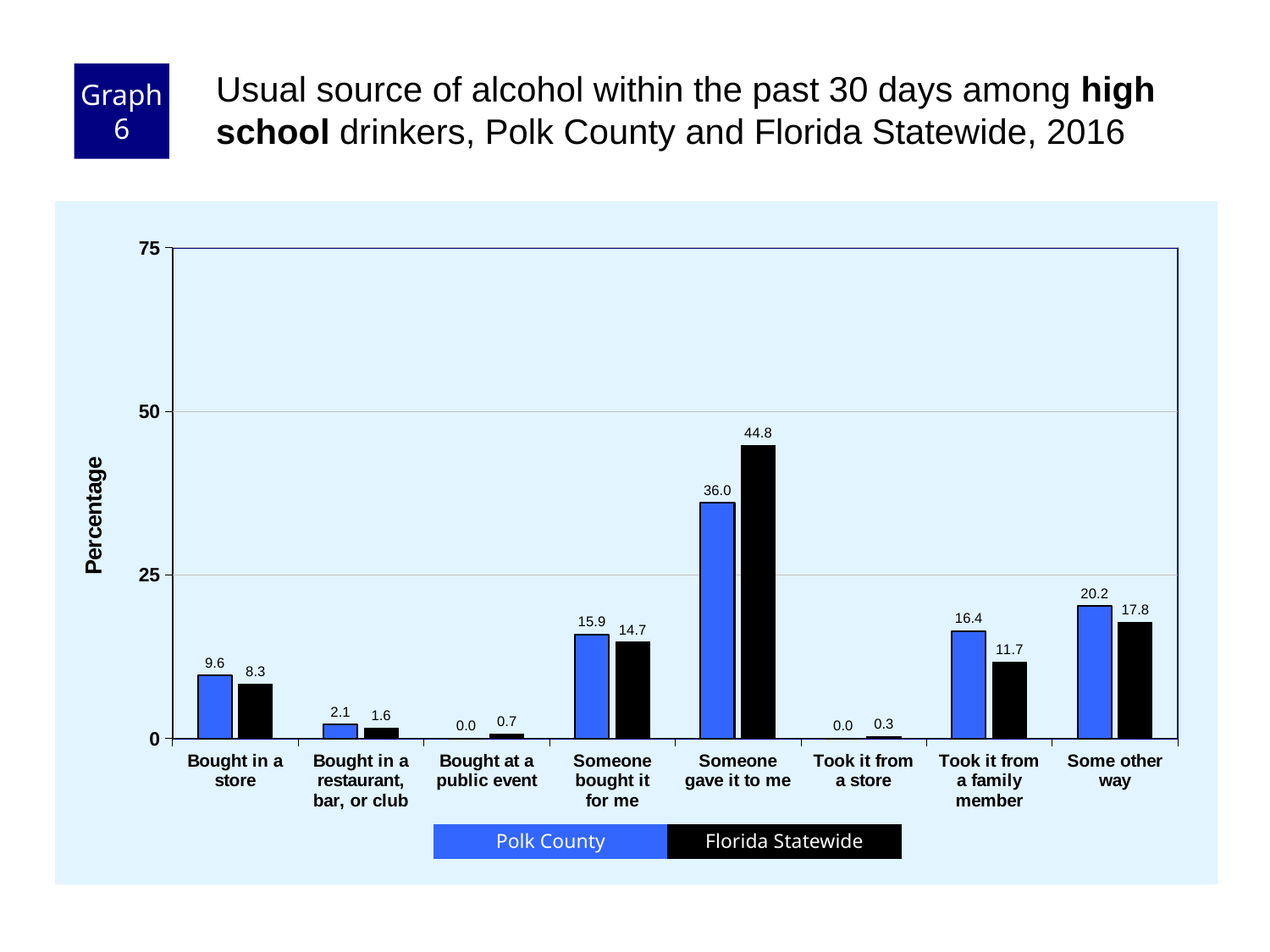
What is the difference between the Florida Statewide and Polk County values for "Someone gave it to me"? 8.8 What is the Florida Statewide value for "Took it from a family member"? 11.7 Which category has the highest Florida Statewide value? Someone gave it to me Which category has the lowest Florida Statewide value? Took it from a store What is the Polk County value for "Someone gave it to me"? 36.0 What is the Polk County value for "Bought in a store"? 9.6 What kind of chart is shown on the slide? bar chart What is the label of the y axis? Percentage How many series does the legend list? 2 How many categories are shown on the x axis? 8 Is the Florida Statewide value for "Someone gave it to me" greater or less than 25? greater Which is larger for "Some other way": Polk County or Florida Statewide? Polk County